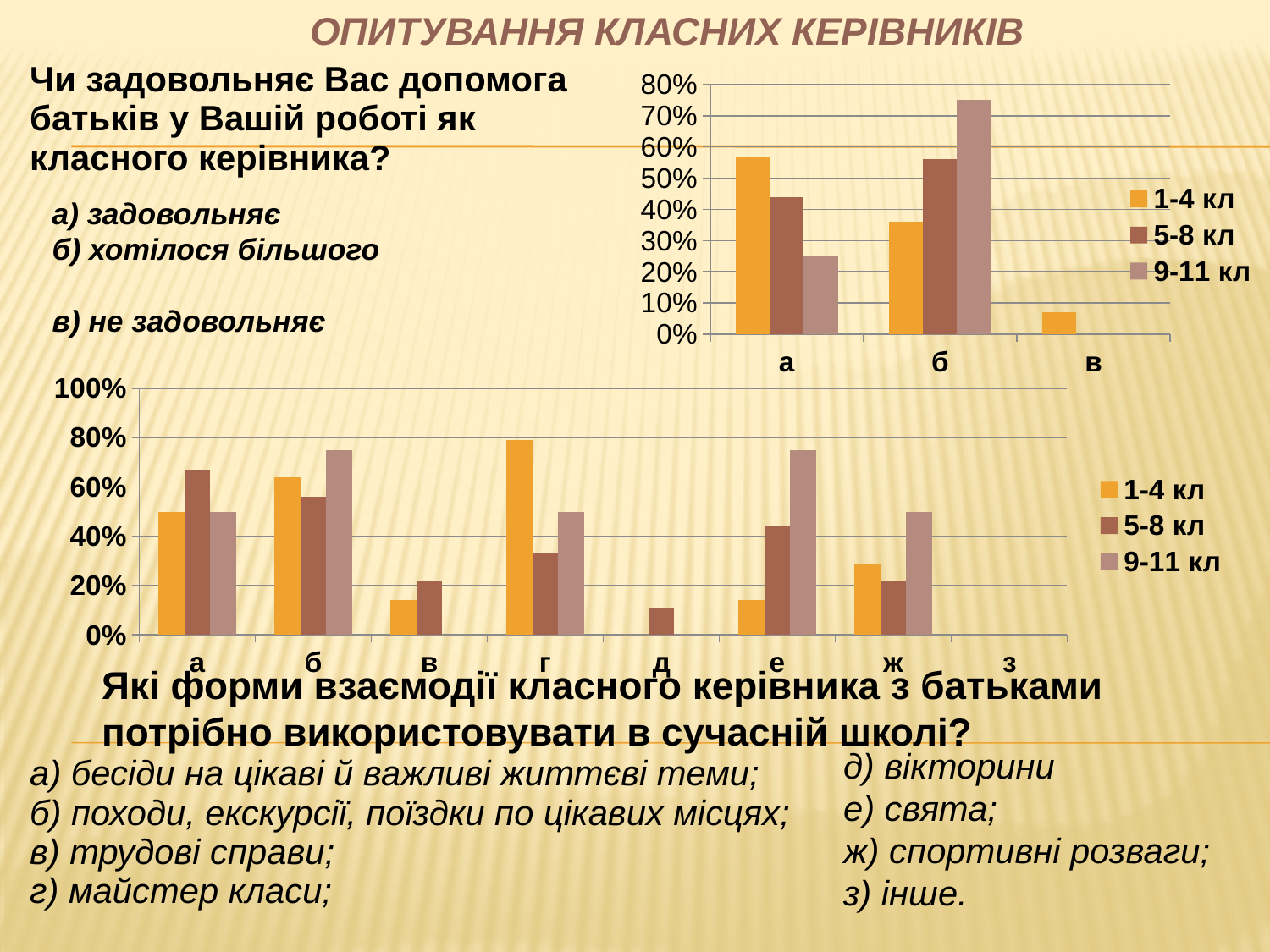
In the bottom chart, is the value for 1-4 кл in category г greater or less than 60%? greater In the top-right chart, which category has the tallest bar for the 9-11 кл series? б In the top-right chart, is the value for 9-11 кл in category б greater or less than 70%? greater In the bottom chart, how many categories are shown on the x axis? 8 In the top-right chart, is the value for 1-4 кл in category в greater or less than 10%? less In the bottom chart, for category е, which is larger: the 1-4 кл bar or the 9-11 кл bar? 9-11 кл In the bottom chart, which category has the tallest bar for the 1-4 кл series? г In the top-right chart, for category а, which is larger: the 1-4 кл bar or the 9-11 кл bar? 1-4 кл In the top-right chart, how many series does the legend list? 3 What type of chart is the bottom chart? bar chart In the top-right chart, how many categories are shown on the x axis? 3